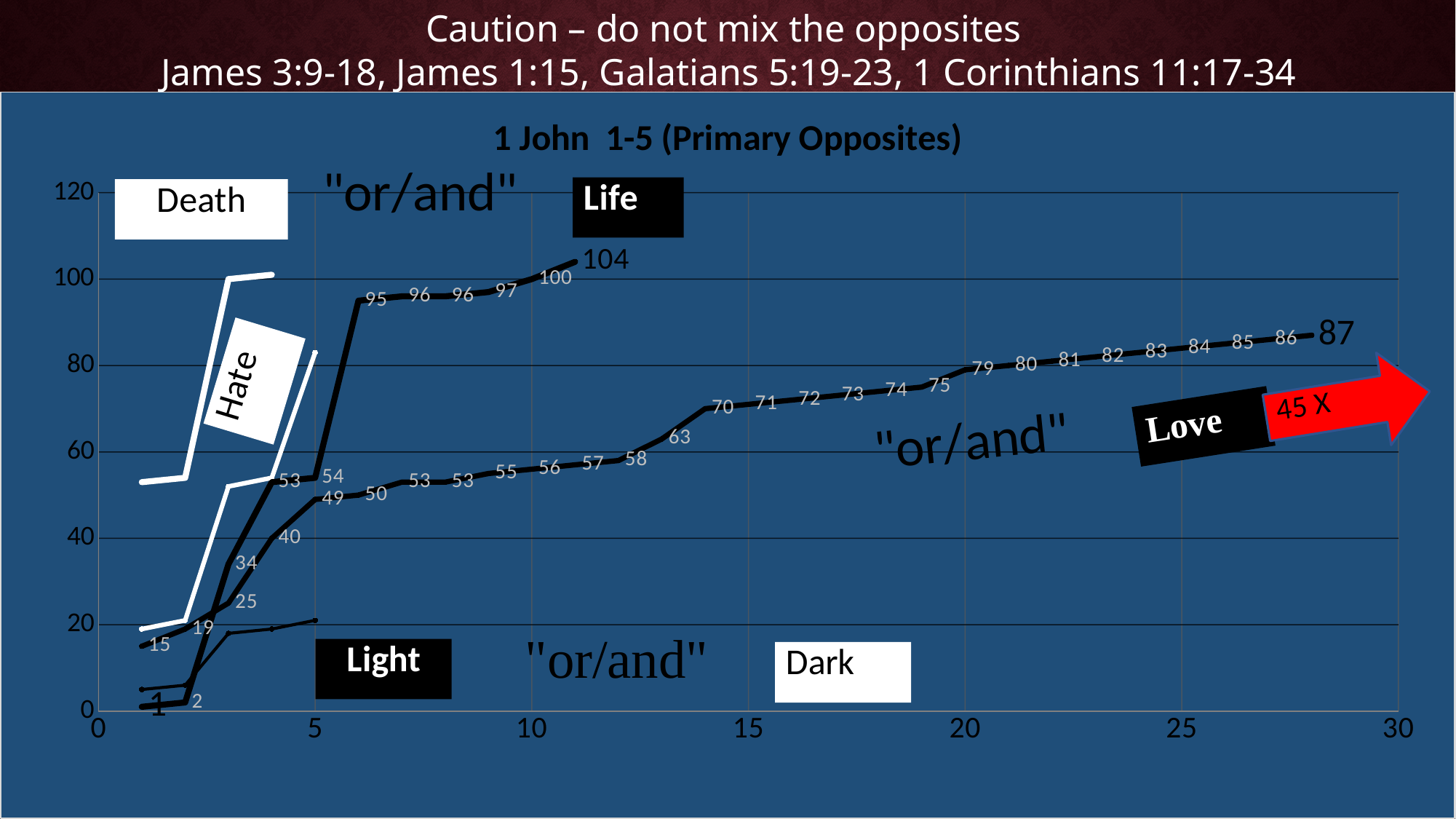
What is the title of the chart? 1 John 1-5 (Primary Opposites) What is the lowest data label shown on the chart? 1 What is the data label on the longest line at x = 14? 70 What is the difference between the highest data label (104) and the final value of the longest line (87)? 17 What is the maximum value shown on the x axis? 30 Is the value of the longest line at x = 20 (labelled 79) greater or less than 60? greater What is the highest data label shown on the chart? 104 Which is larger: the end value of the line labelled 104 or the end value of the line labelled 87? 104 What is the maximum value shown on the y axis? 120 What is the final data label on the line that extends furthest to the right (near the 'Love' label)? 87 What kind of chart is shown on the slide? line chart Do the values on the longest line rise or fall as x increases? rise